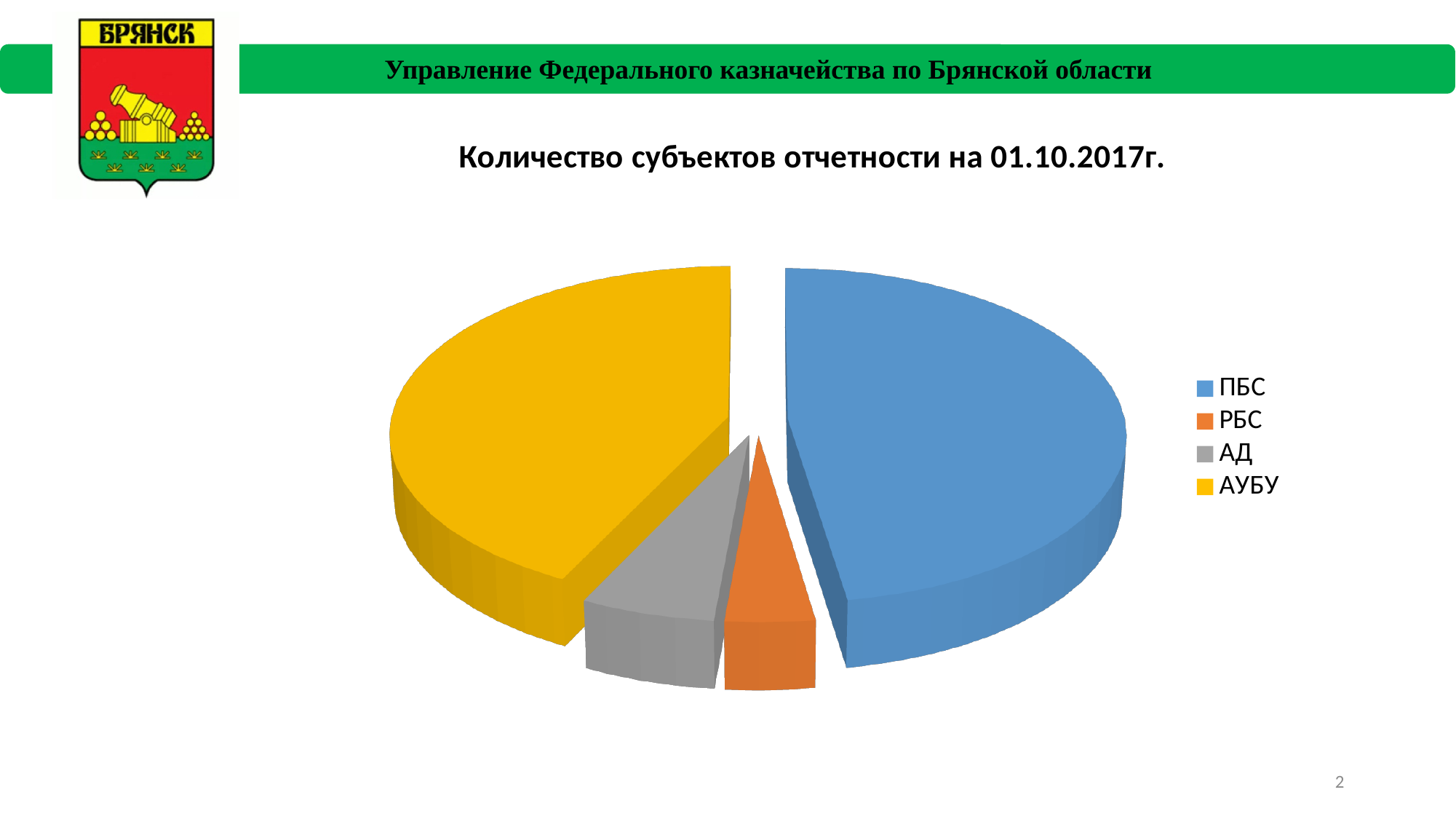
What is the title of the chart? Количество субъектов отчетности на 01.10.2017г. How many slices does the pie chart have? 4 What colour is the АУБУ slice in the pie chart? yellow What kind of chart is shown on the slide? pie chart Which category has the smallest slice of the pie? РБС Which slice is larger, АД or РБС? АД Which slice is larger, АУБУ or АД? АУБУ Which slice is larger, ПБС or РБС? ПБС How many entries does the legend list? 4